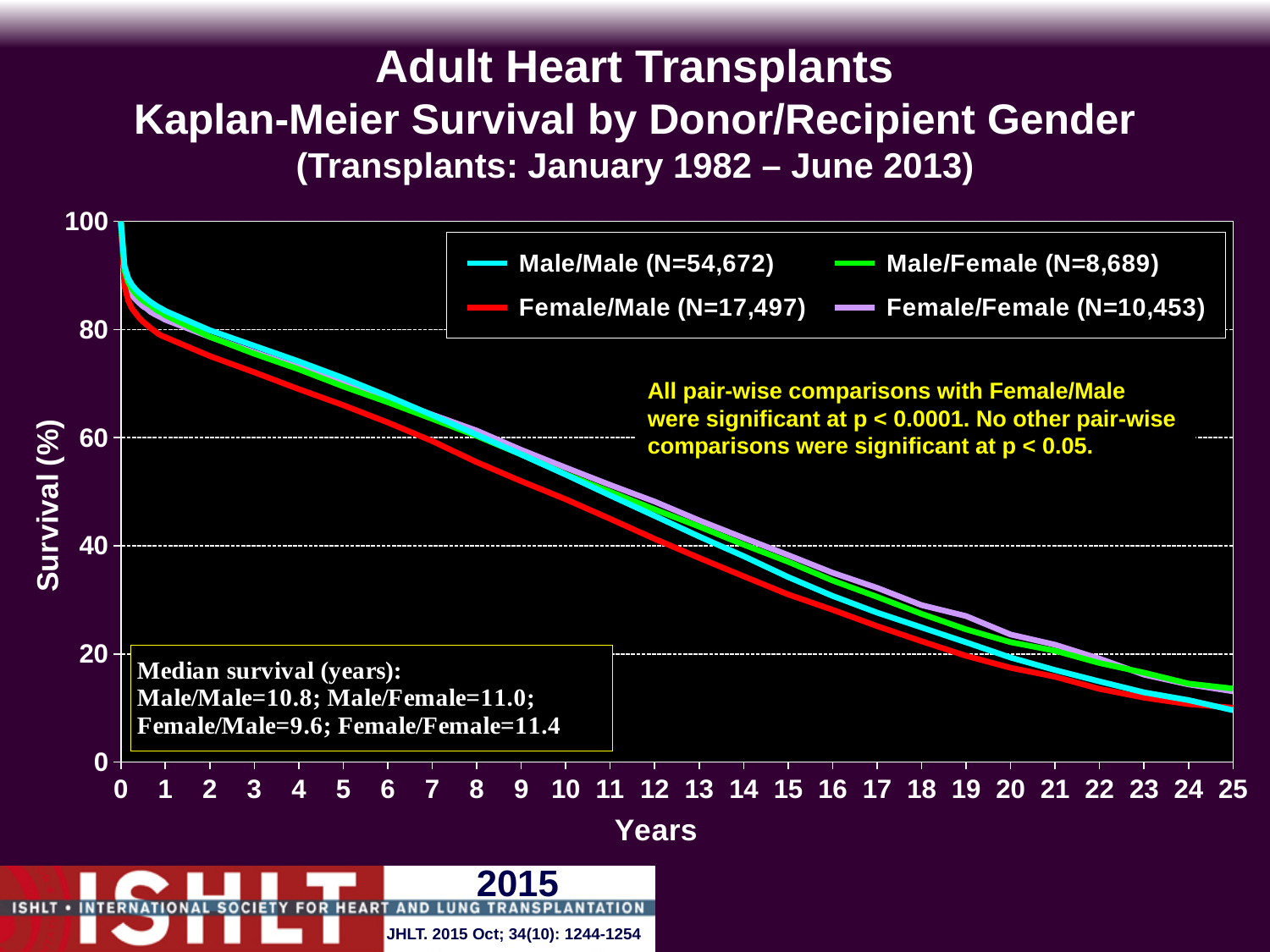
What is the N for the Male/Male group shown in the legend? 54,672 What kind of chart is shown on the slide? Line chart Do the survival curves rise or fall as years increase? Fall What is the median survival in years for the Female/Male group? 9.6 Is the survival for Female/Male at 10 years greater or less than 60? less What colour is the Female/Male line in the chart? Red What is the difference in median survival (years) between Female/Female and Female/Male? 1.8 What is the median survival in years for the Female/Female group? 11.4 How many series does the legend list? 4 Which donor/recipient group has the lowest median survival? Female/Male Which donor/recipient group has the highest median survival? Female/Female Which group has a larger N, Male/Female or Female/Female? Female/Female